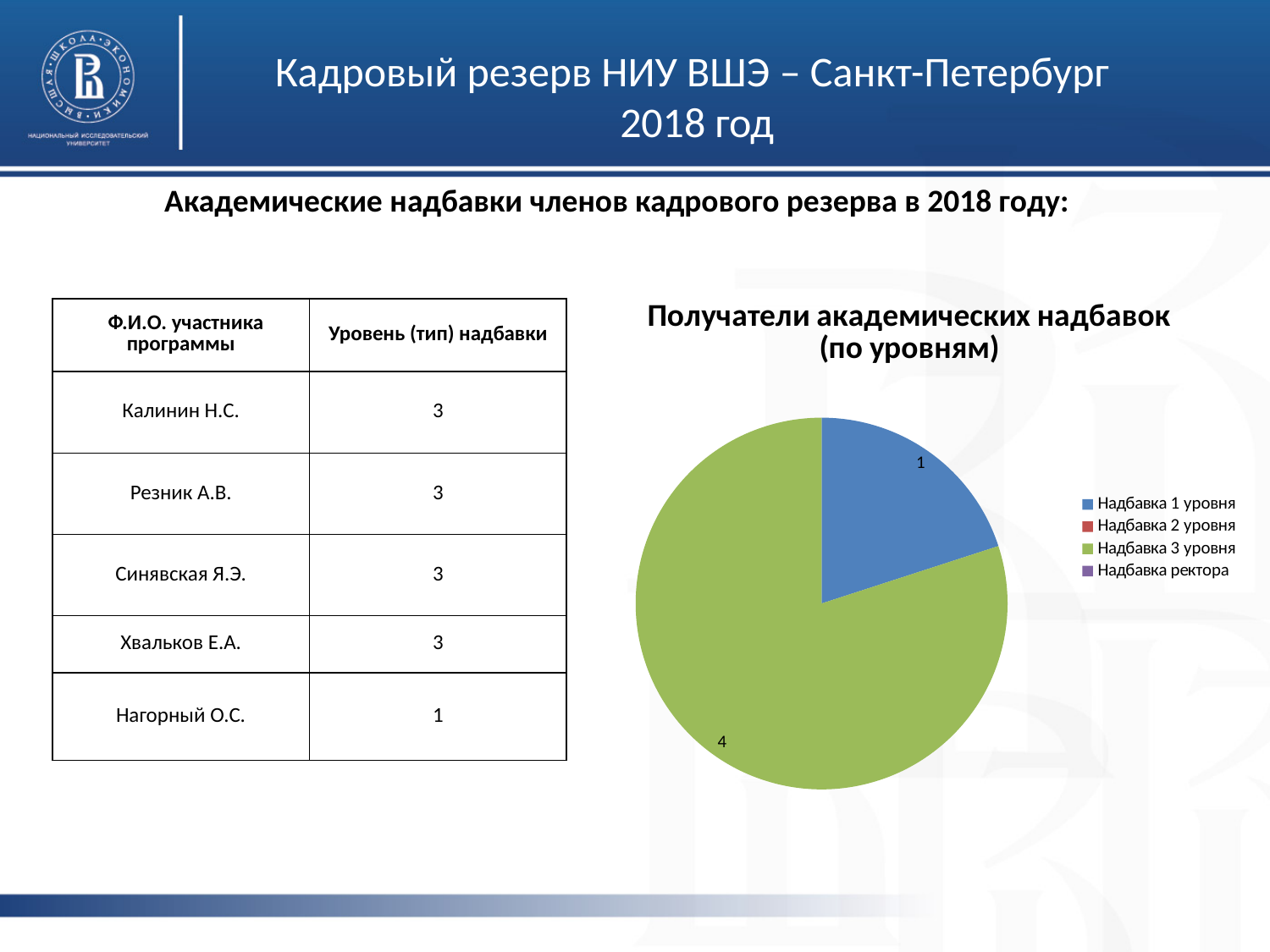
What is the total of the values labelled on the pie chart? 5 What share of the pie does the 'Надбавка 3 уровня' slice represent? 80% How many entries does the legend of the pie chart list? 4 What share of the pie does the 'Надбавка 1 уровня' slice represent? 20% Which is larger in the pie chart: 'Надбавка 1 уровня' or 'Надбавка 3 уровня'? Надбавка 3 уровня What value is shown for the 'Надбавка 1 уровня' slice of the pie chart? 1 What is the title of the pie chart? Получатели академических надбавок (по уровням) Which legend category has the largest slice in the pie chart? Надбавка 3 уровня What value is shown for the 'Надбавка 3 уровня' slice of the pie chart? 4 What is the difference between the values for 'Надбавка 3 уровня' and 'Надбавка 1 уровня' in the pie chart? 3 What colour is the largest slice of the pie chart? green What kind of chart is shown on the slide? pie chart